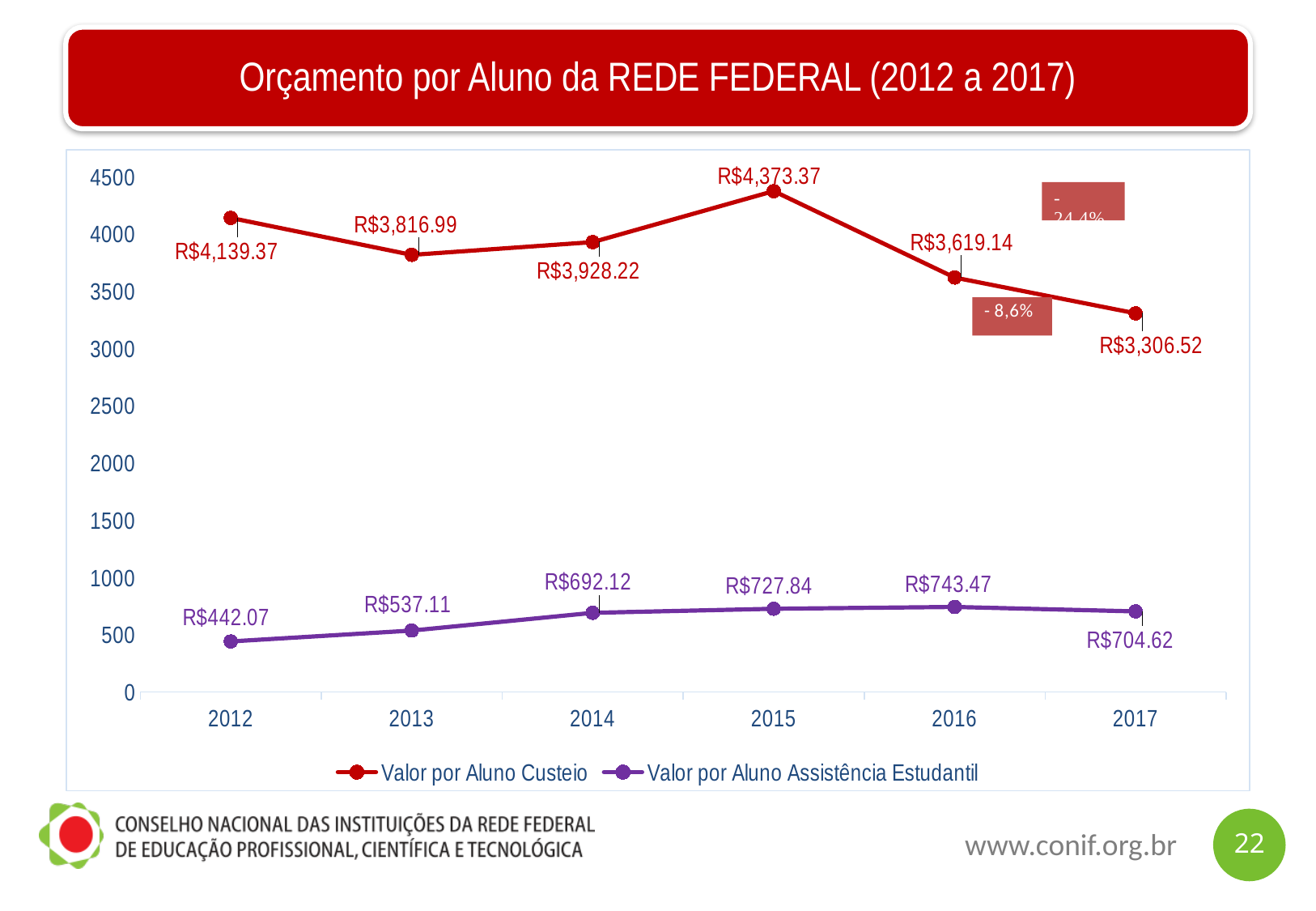
What is the value for Valor por Aluno Custeio in 2017? R$3,306.52 What type of chart is shown on the slide? Line chart What is the value for Valor por Aluno Custeio in 2015? R$4,373.37 In which year is Valor por Aluno Assistência Estudantil lowest? 2012 How many series does the legend list? 2 What is the difference between Valor por Aluno Custeio in 2015 and in 2017? R$1,066.85 In which year is Valor por Aluno Custeio highest? 2015 What is the value for Valor por Aluno Assistência Estudantil in 2012? R$442.07 Which is larger: Valor por Aluno Custeio in 2012 or in 2013? 2012 Is the value for Valor por Aluno Custeio in 2016 greater or less than 4000? less What is the title of the chart? Orçamento por Aluno da REDE FEDERAL (2012 a 2017) How many years are plotted on the x axis? 6